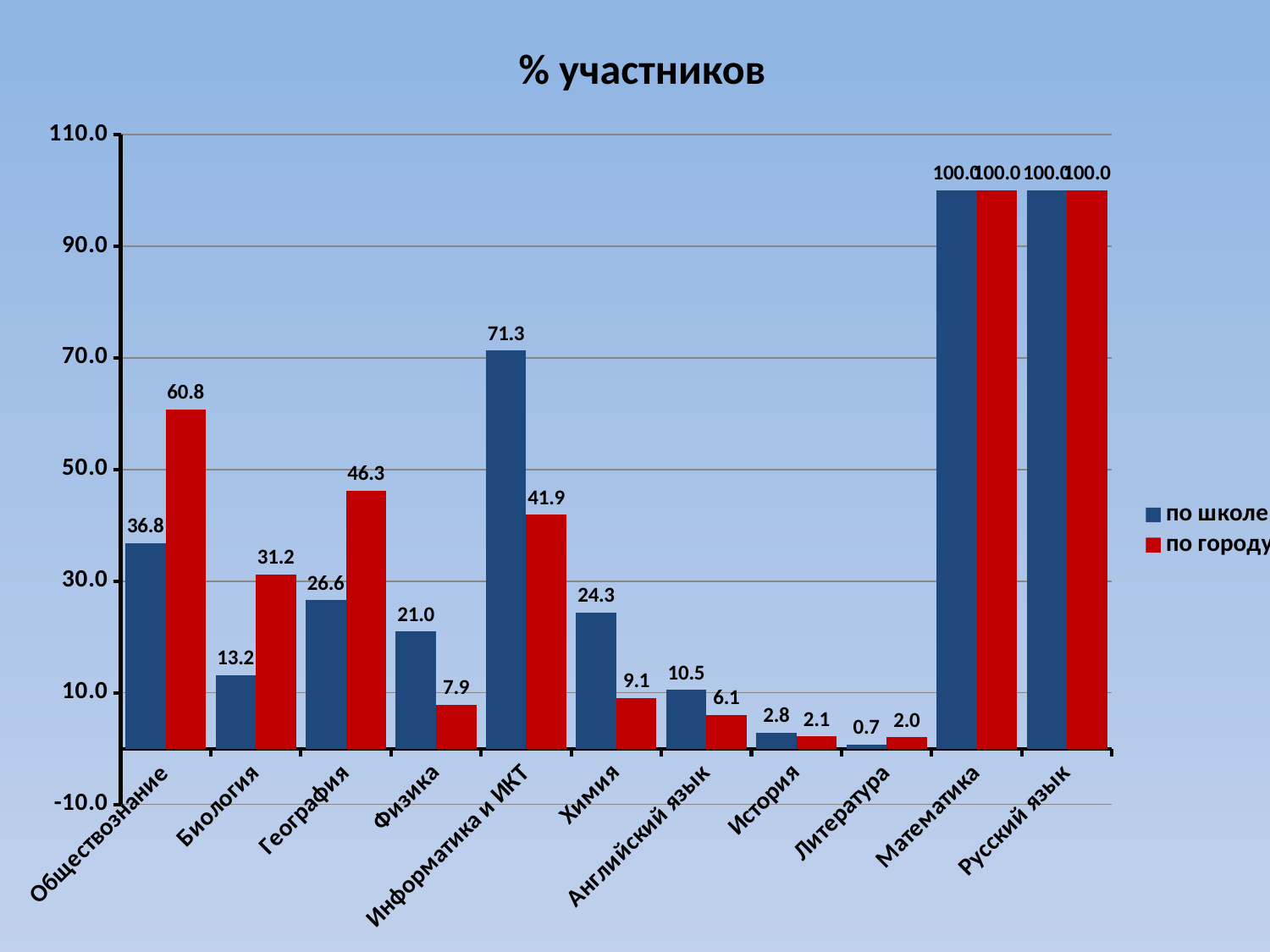
How many categories are shown on the x axis? 11 Which is larger for Биология: the по школе value or the по городу value? по городу What is the value for Обществознание in the по школе series? 36.8 Which category has the lowest value in the по городу series? Литература What is the difference between the по городу and по школе values for Обществознание? 24.0 What is the value for Литература in the по городу series? 2.0 What is the value for Информатика и ИКТ in the по школе series? 71.3 How many series does the legend list? 2 Which category has the lowest value in the по школе series? Литература Which is larger for Физика: the по школе value or the по городу value? по школе What kind of chart is shown on the slide? bar chart What is the value for География in the по городу series? 46.3